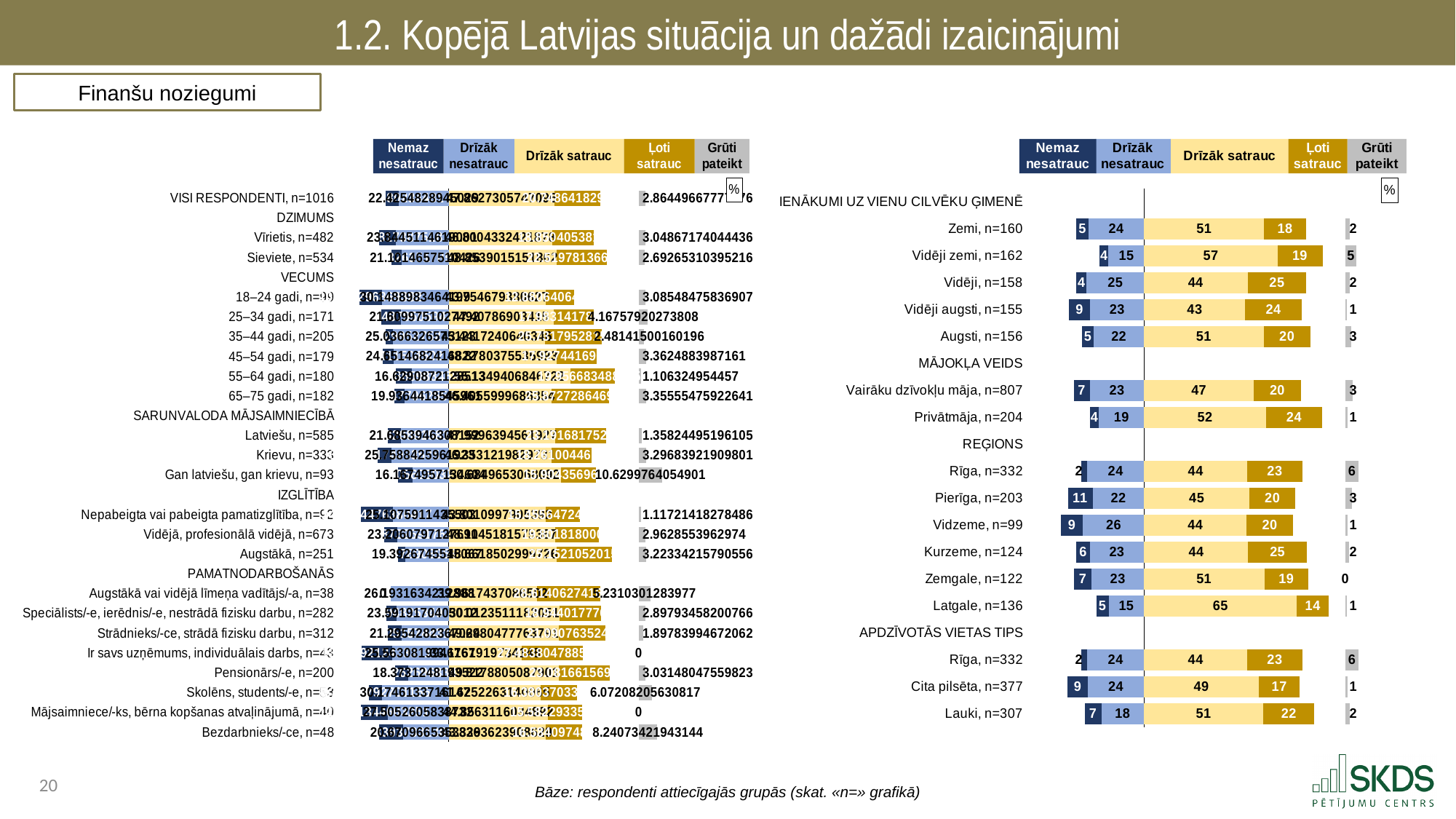
In the chart on the right, what is the 'Ļoti satrauc' value for Privātmāja, n=204? 24 In the chart on the right, what is the difference between the 'Drīzāk satrauc' values for Vidēji zemi, n=162 and Vidēji, n=158? 13 In the chart on the right, which region under REĢIONS has the highest 'Drīzāk satrauc' value? Latgale, n=136 In the chart on the right, which has a larger 'Ļoti satrauc' value: Kurzeme, n=124 or Cita pilsēta, n=377? Kurzeme, n=124 In the chart on the right, what is the 'Grūti pateikt' value for Zemgale, n=122? 0 In the chart on the right, what is the 'Nemaz nesatrauc' value for Pierīga, n=203? 11 In the chart on the right, what is the 'Drīzāk satrauc' value for Latgale, n=136? 65 In the chart on the right, which legend entry is shown in dark blue? Nemaz nesatrauc How many series does the legend of the chart on the right list? 5 In the chart on the right, which income group under IENĀKUMI UZ VIENU CILVĒKU ĢIMENĒ has the lowest 'Drīzāk nesatrauc' value? Vidēji zemi, n=162 In the chart on the right, what is the total of the 'Nemaz nesatrauc' and 'Drīzāk nesatrauc' segments for Vidzeme, n=99? 35 What kind of chart is the chart on the right? Stacked bar chart